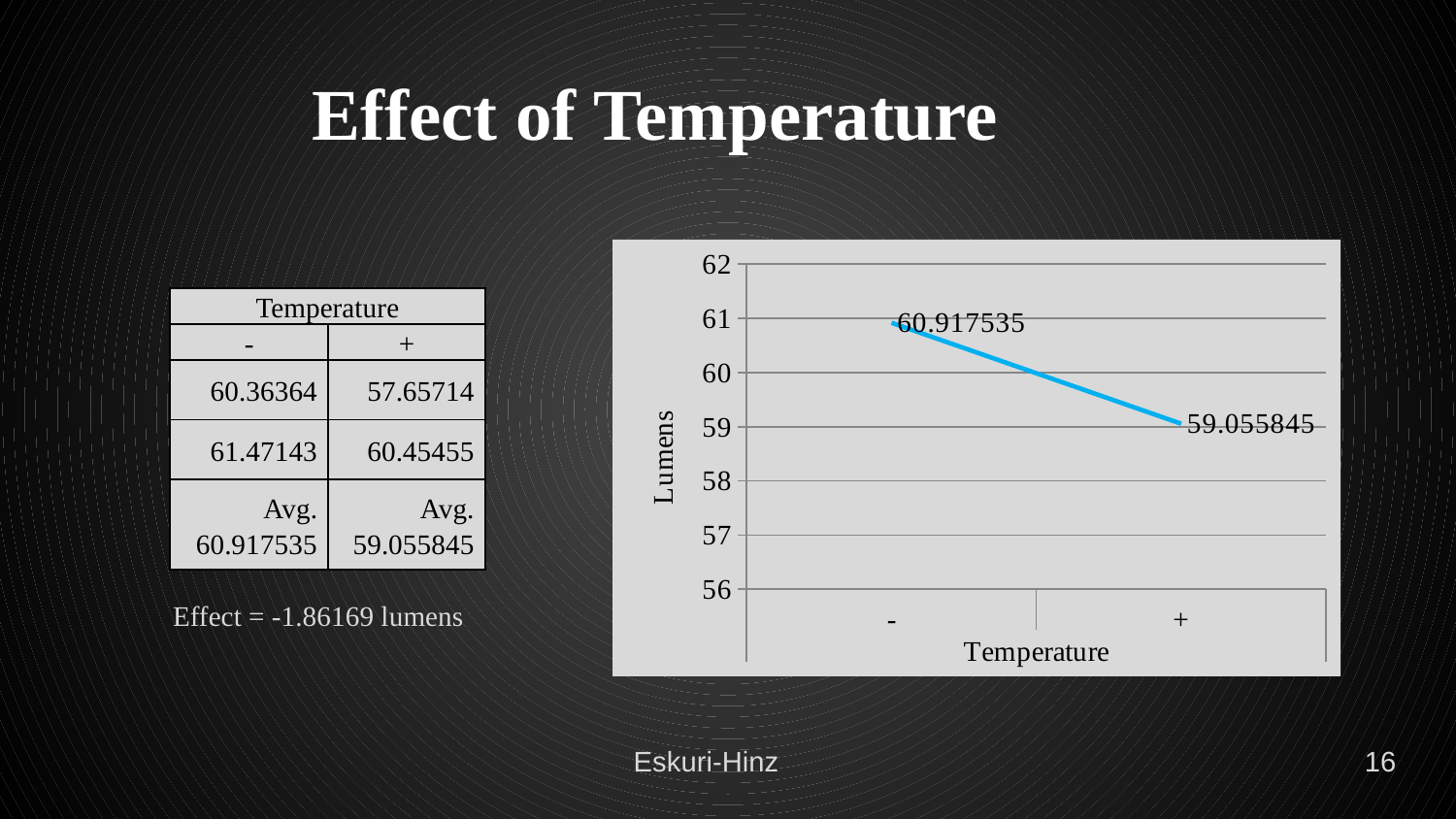
Which temperature level has the lower Lumens value? + Is the Lumens value at the "-" level greater or less than 60? greater What is the label of the y axis of the chart? Lumens Is the Lumens value at the "+" level greater or less than 60? less What is the Lumens value at the "+" temperature level? 59.055845 What type of chart is shown on the slide? line chart Do the Lumens values rise or fall from "-" to "+" along the x axis? fall What is the Lumens value at the "-" temperature level? 60.917535 Which temperature level has the higher Lumens value? - What is the difference in Lumens between the "-" and "+" temperature levels? 1.86169 Is the Lumens value at "-" larger or smaller than the value at "+"? larger How many data points are plotted on the chart? 2